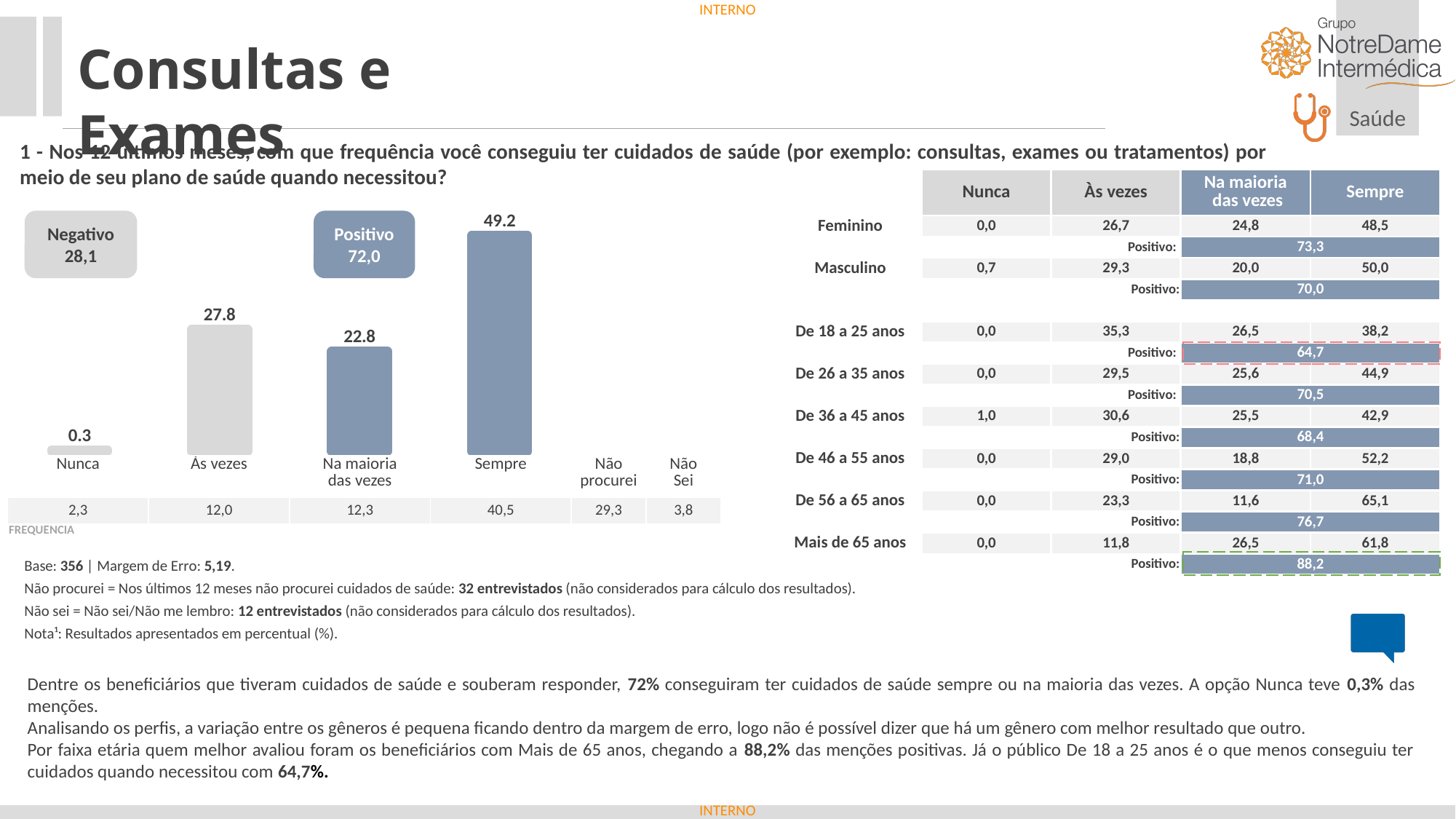
What is the value shown for 'Nunca' in the bar chart? 0.3 How many categories in the chart have a bar with a data label? 4 What is the value shown for 'Sempre' in the bar chart? 49.2 What type of chart is shown on the slide? bar chart What is the value shown for 'Às vezes' in the bar chart? 27.8 Which category has the lowest bar in the chart? Nunca What value is shown in the 'Positivo' box above the chart? 72,0 Which category has the highest bar in the chart? Sempre What value is shown in the 'Negativo' box above the chart? 28,1 Which is larger, the value for 'Às vezes' or the value for 'Na maioria das vezes'? Às vezes What is the value shown for 'Na maioria das vezes' in the bar chart? 22.8 What is the difference between the values for 'Sempre' and 'Às vezes'? 21.4